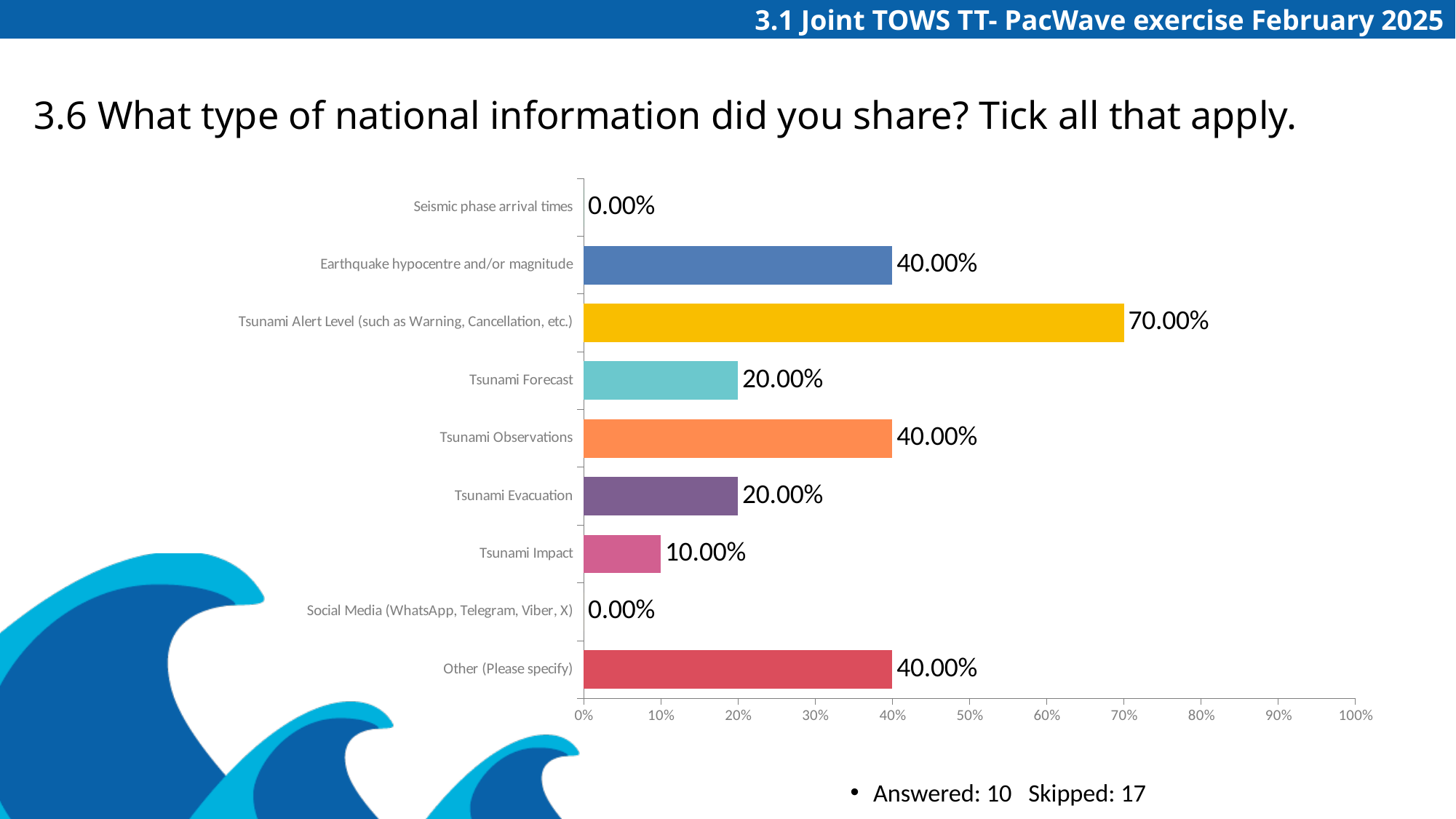
What colour is the bar for Tsunami Alert Level (such as Warning, Cancellation, etc.)? Yellow Which category has the highest percentage? Tsunami Alert Level (such as Warning, Cancellation, etc.) How many categories are shown on the chart? 9 What is the difference between the percentages for Tsunami Alert Level and Earthquake hypocentre and/or magnitude? 30.00% What is the difference between the percentages for Tsunami Observations and Tsunami Impact? 30.00% Is the value for Tsunami Alert Level greater or less than 60%? greater What percentage is shown for Tsunami Alert Level (such as Warning, Cancellation, etc.)? 70.00% What type of chart is shown on the slide? Bar chart Which is larger, the percentage for Tsunami Forecast or the percentage for Other (Please specify)? Other (Please specify) What percentage is shown for Tsunami Impact? 10.00% What percentage is shown for Social Media (WhatsApp, Telegram, Viber, X)? 0.00% What percentage is shown for Tsunami Forecast? 20.00%